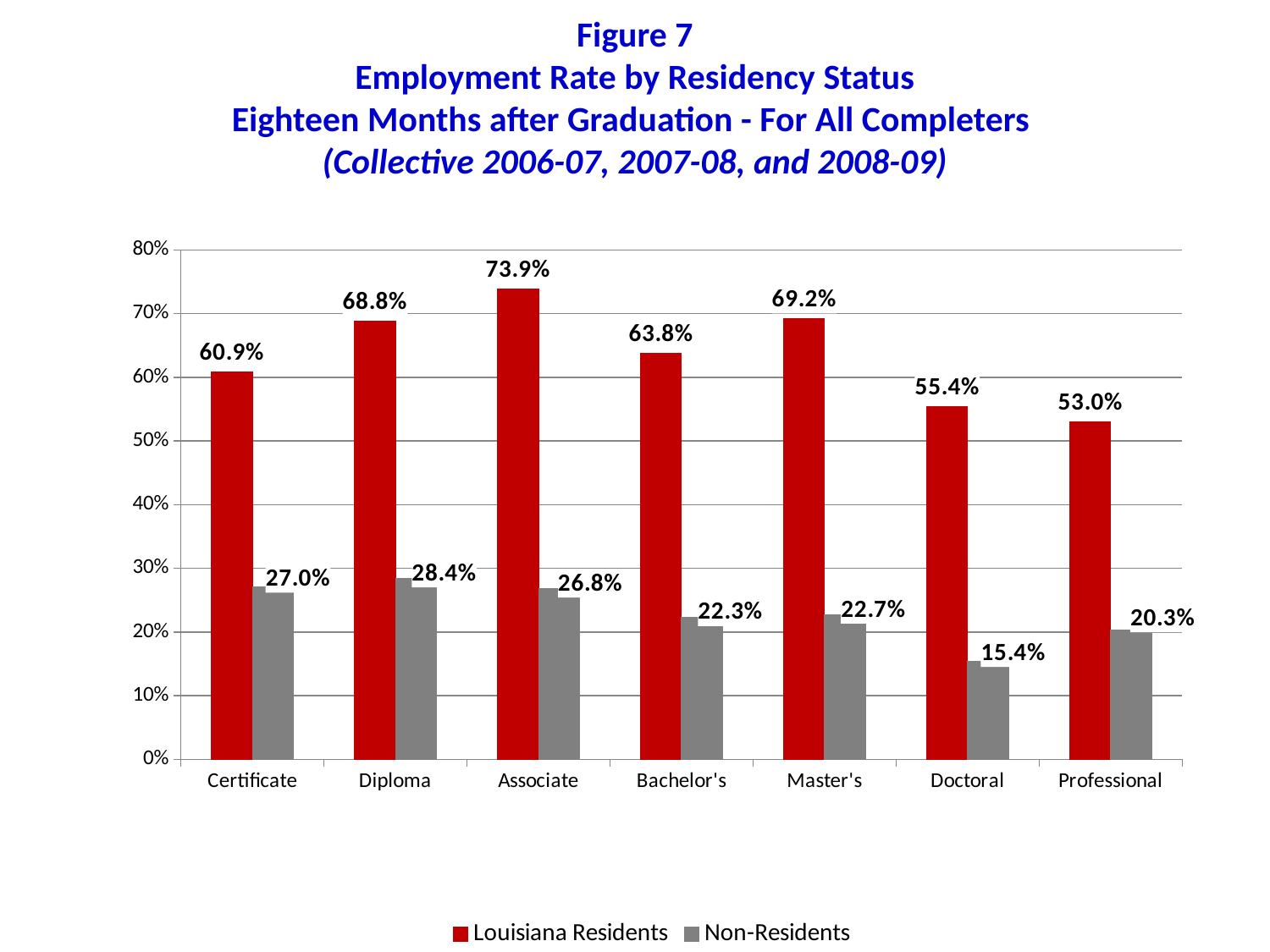
Is the Louisiana Residents value for Doctoral greater or less than 60%? less How many degree categories are shown on the x axis? 7 Which is larger: the Louisiana Residents rate for Diploma or for Master's? Master's How many series does the legend list? 2 What is the difference between the Louisiana Residents and Non-Residents employment rates for the Certificate category? 33.9% Which category has the highest employment rate for Louisiana Residents? Associate What is the employment rate for Louisiana Residents with an Associate degree? 73.9% What is the employment rate for Louisiana Residents in the Professional category? 53.0% What is the employment rate for Non-Residents with a Doctoral degree? 15.4% What kind of chart is shown on the slide? Bar chart Which category has the highest employment rate for Non-Residents? Diploma Which category has the lowest employment rate for Non-Residents? Doctoral